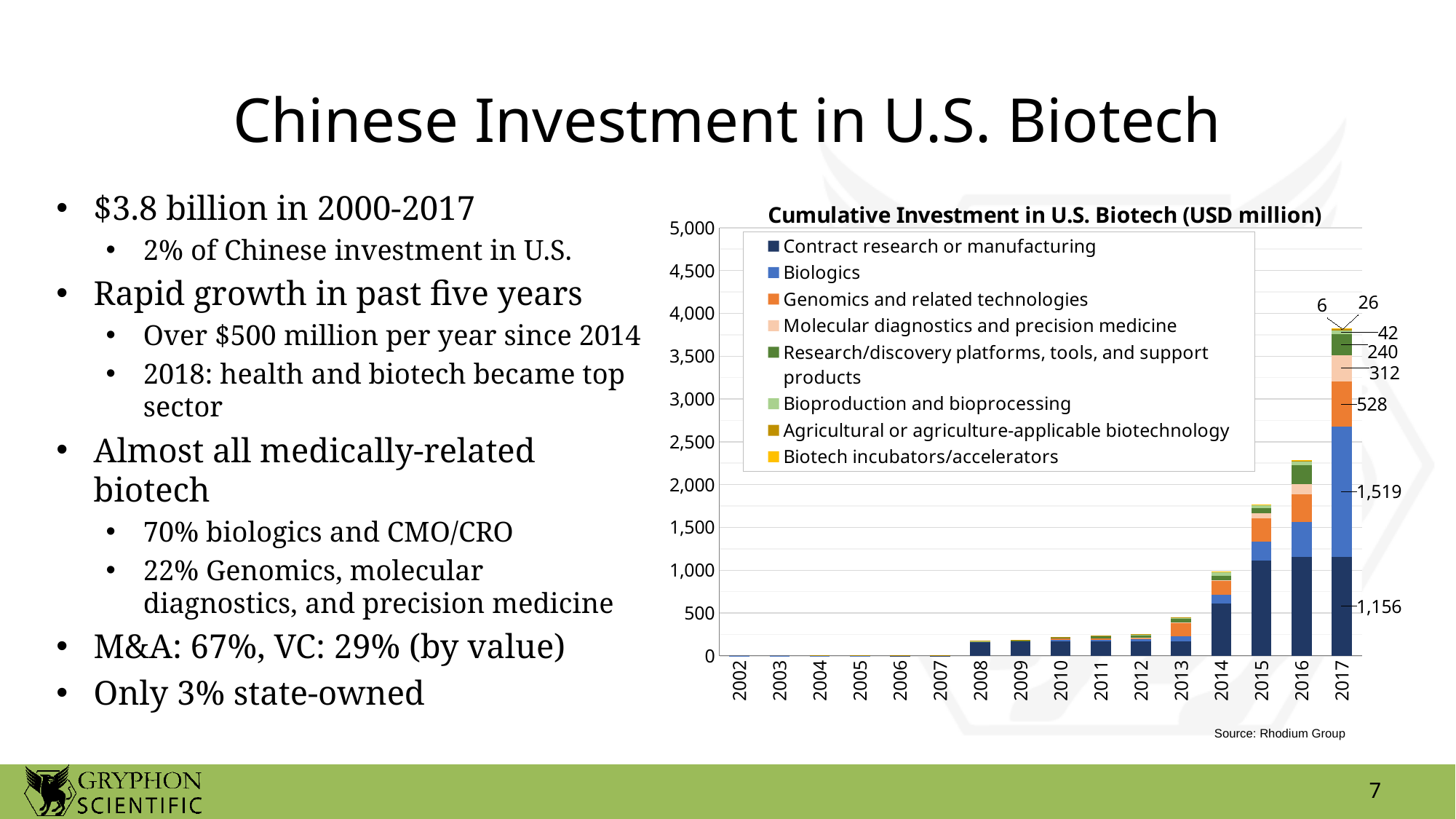
What is the value for Contract research or manufacturing in 2017? 1,156 How many years are shown along the x axis of the chart? 16 What is the value for Molecular diagnostics and precision medicine in 2017? 312 What is the title of the chart? Cumulative Investment in U.S. Biotech (USD million) What is the value for Biologics in 2017? 1,519 In 2017, how much larger is Biologics than Contract research or manufacturing? 363 Is the total value of the 2013 bar greater or less than 500? less What kind of chart is shown on the slide? Stacked bar chart Which year has the tallest bar in the chart? 2017 In 2017, which is larger: Genomics and related technologies or Molecular diagnostics and precision medicine? Genomics and related technologies What is the value for Genomics and related technologies in 2017? 528 How many series does the chart legend list? 8